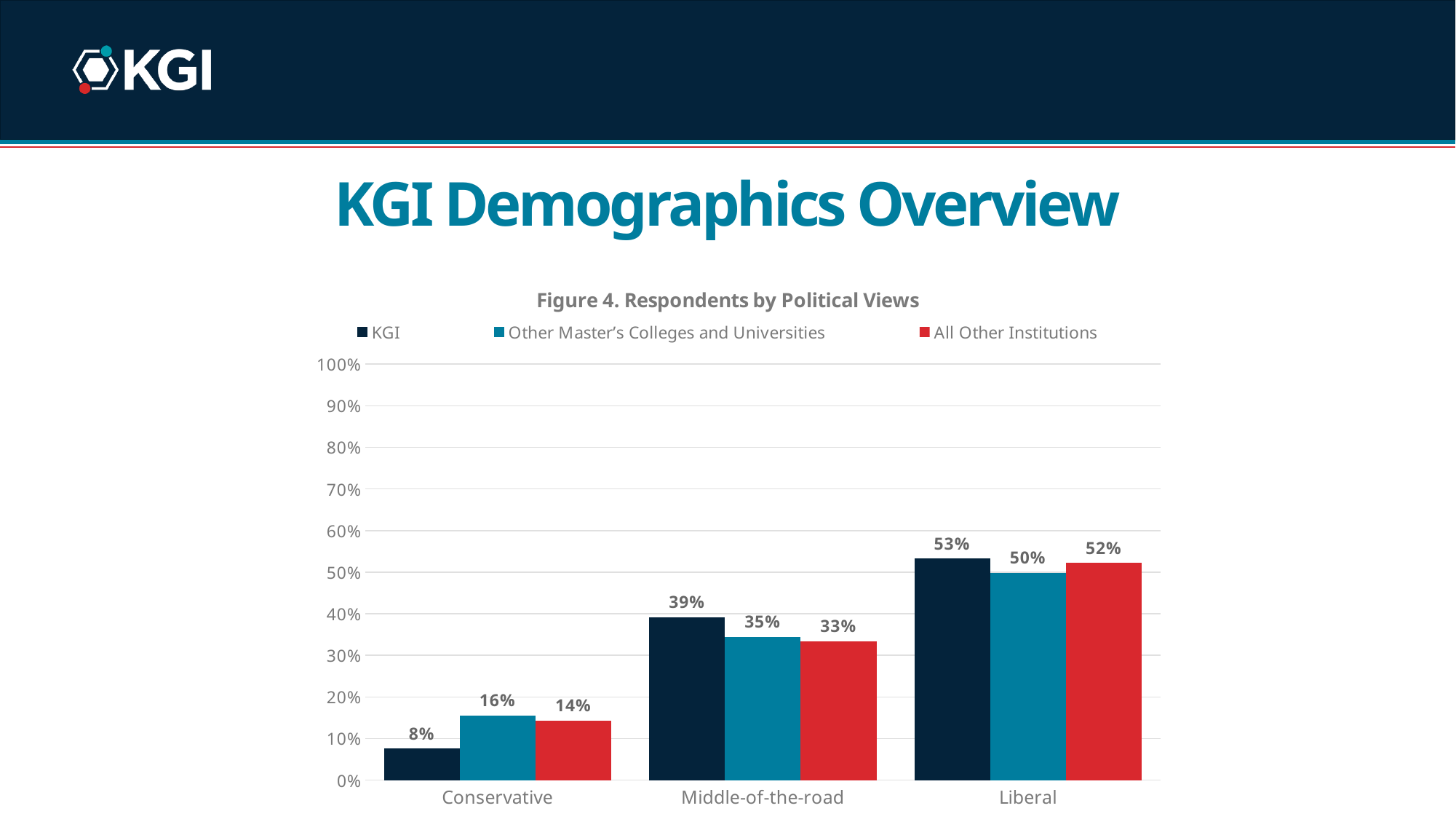
What is the value for Other Master's Colleges and Universities in the Middle-of-the-road category? 35% What percentage of KGI respondents are Conservative? 8% Which political view category has the lowest value for All Other Institutions? Conservative How many series does the legend list? 3 What is the title of the chart? Figure 4. Respondents by Political Views What is the value for All Other Institutions in the Liberal category? 52% What is the difference between the KGI value and the Other Master's Colleges and Universities value in the Conservative category? 8% How many political view categories are shown on the x axis? 3 In the Middle-of-the-road category, which is larger: the KGI value or the All Other Institutions value? KGI What kind of chart is shown on the slide? Bar chart Which political view category has the highest value for KGI? Liberal Do the KGI values rise or fall from Conservative to Liberal along the x axis? Rise